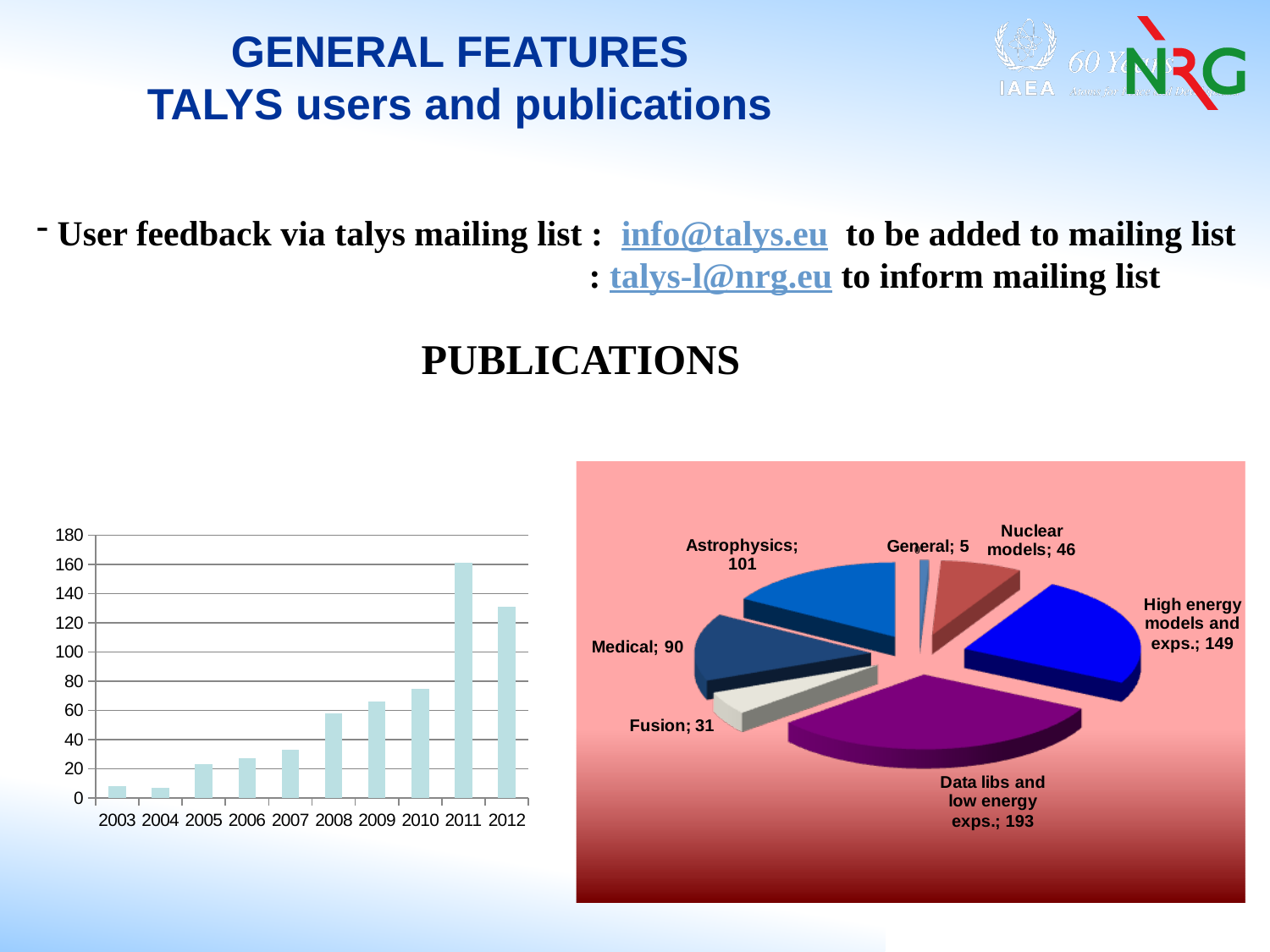
On the left bar chart, which is larger, the value for 2011 or the value for 2012? 2011 On the left bar chart, how many years are shown on the x axis? 10 On the right pie chart, which category has the largest value? Data libs and low energy exps. On the right pie chart, what is the value for Medical? 90 On the left bar chart, is the value for 2012 greater or less than 120? greater On the right pie chart, what is the value for High energy models and exps.? 149 What kind of chart is the chart on the left of the slide? bar chart On the right pie chart, what is the difference between the values for Astrophysics and Fusion? 70 On the left bar chart, which year has the highest value? 2011 On the right pie chart, which category has the smallest value? General